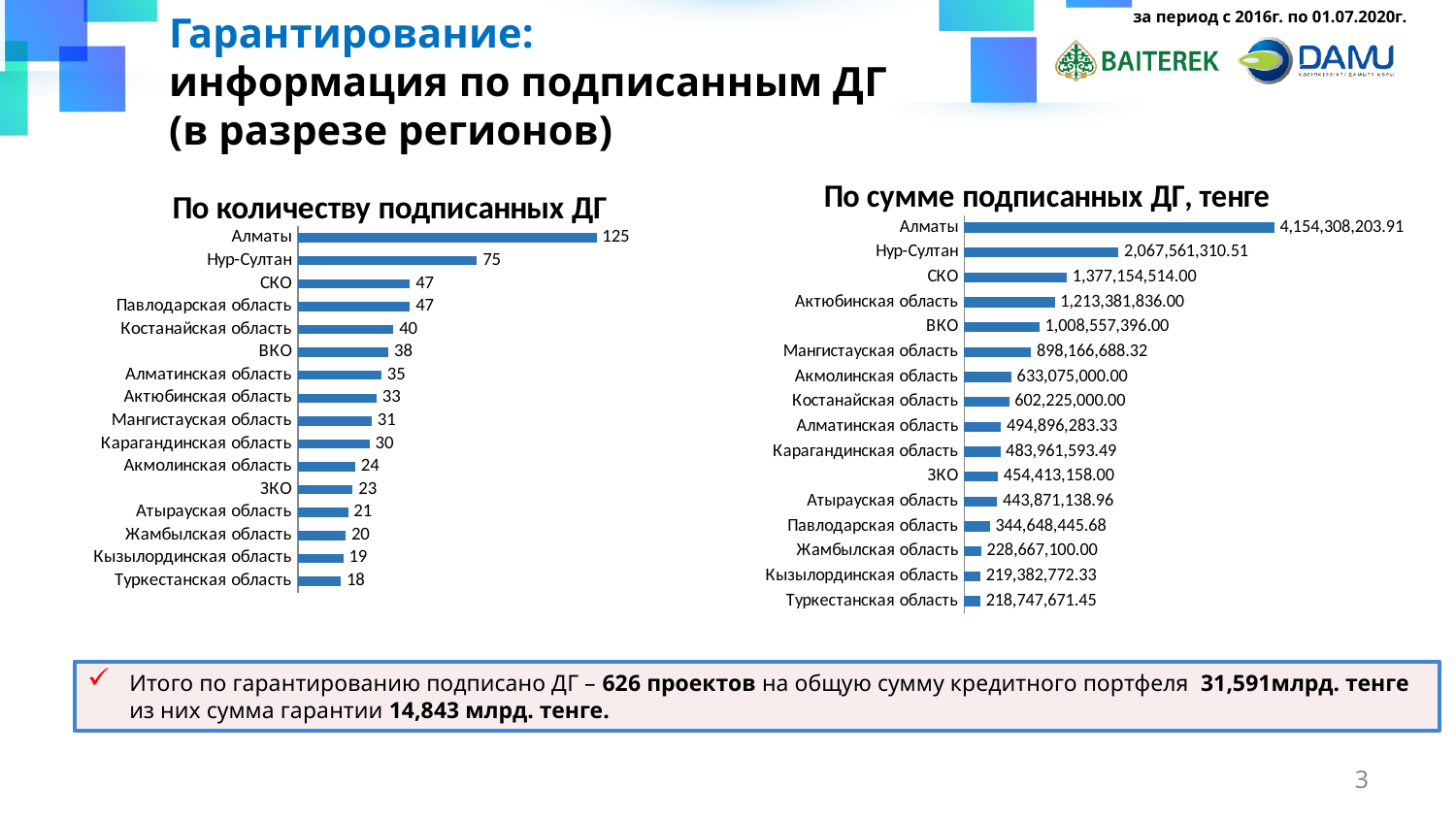
In the chart 'По сумме подписанных ДГ, тенге', which region has the lowest value? Туркестанская область In the chart 'По количеству подписанных ДГ', which region has the lowest value? Туркестанская область In the chart 'По количеству подписанных ДГ', how many regions are shown? 16 In the chart 'По сумме подписанных ДГ, тенге', what is the value for Актюбинская область? 1,213,381,836.00 In the chart 'По сумме подписанных ДГ, тенге', which is larger: the value for ВКО or the value for Мангистауская область? ВКО In the chart 'По количеству подписанных ДГ', which is larger: the value for Костанайская область or the value for ВКО? Костанайская область In the chart 'По количеству подписанных ДГ', what is the value for Мангистауская область? 31 What type of chart is 'По сумме подписанных ДГ, тенге'? Bar chart In the chart 'По количеству подписанных ДГ', what is the value for Нур-Султан? 75 In the chart 'По сумме подписанных ДГ, тенге', what is the value for Алматы? 4,154,308,203.91 In the chart 'По количеству подписанных ДГ', what is the difference between the values for Алматы and Нур-Султан? 50 In the chart 'По количеству подписанных ДГ', which region has the highest value? Алматы